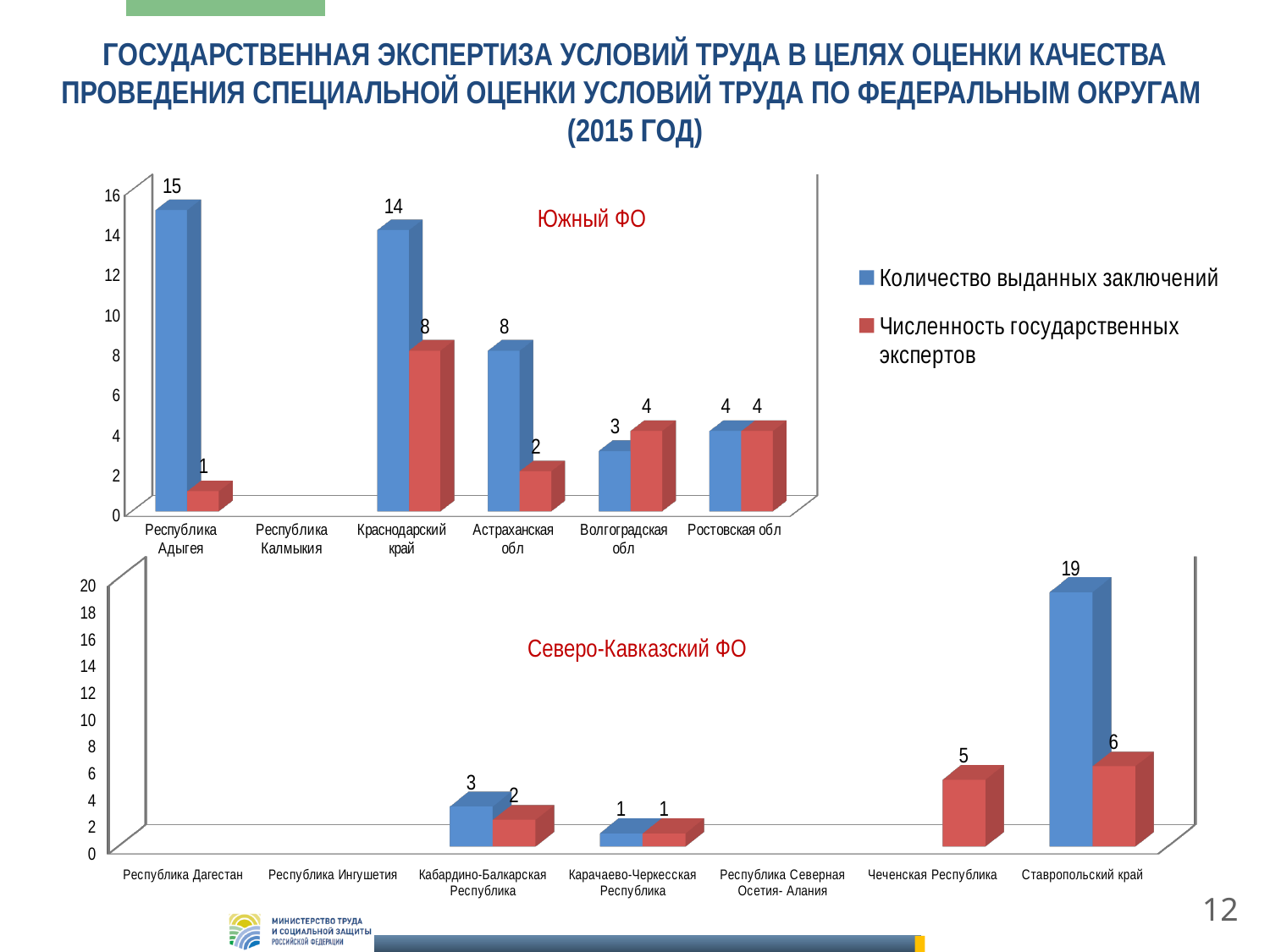
In the Южный ФО chart, what is the value of Количество выданных заключений for Республика Адыгея? 15 What kind of chart is the Южный ФО chart? Bar chart How many series does the legend list? 2 How many regions are listed on the x axis of the Северо-Кавказский ФО chart? 7 In the Южный ФО chart, which is larger for Волгоградская обл: Количество выданных заключений or Численность государственных экспертов? Численность государственных экспертов In the Южный ФО chart, what is the difference between Количество выданных заключений and Численность государственных экспертов for Астраханская обл? 6 In the Северо-Кавказский ФО chart, what is the value of Количество выданных заключений for Ставропольский край? 19 In the Северо-Кавказский ФО chart, what is the difference between Количество выданных заключений and Численность государственных экспертов for Ставропольский край? 13 In the Северо-Кавказский ФО chart, which region has the highest value of Численность государственных экспертов? Ставропольский край In the Южный ФО chart, which region has the highest value of Количество выданных заключений? Республика Адыгея In the Северо-Кавказский ФО chart, what is the value of Численность государственных экспертов for Чеченская Республика? 5 In the Южный ФО chart, what is the value of Численность государственных экспертов for Краснодарский край? 8